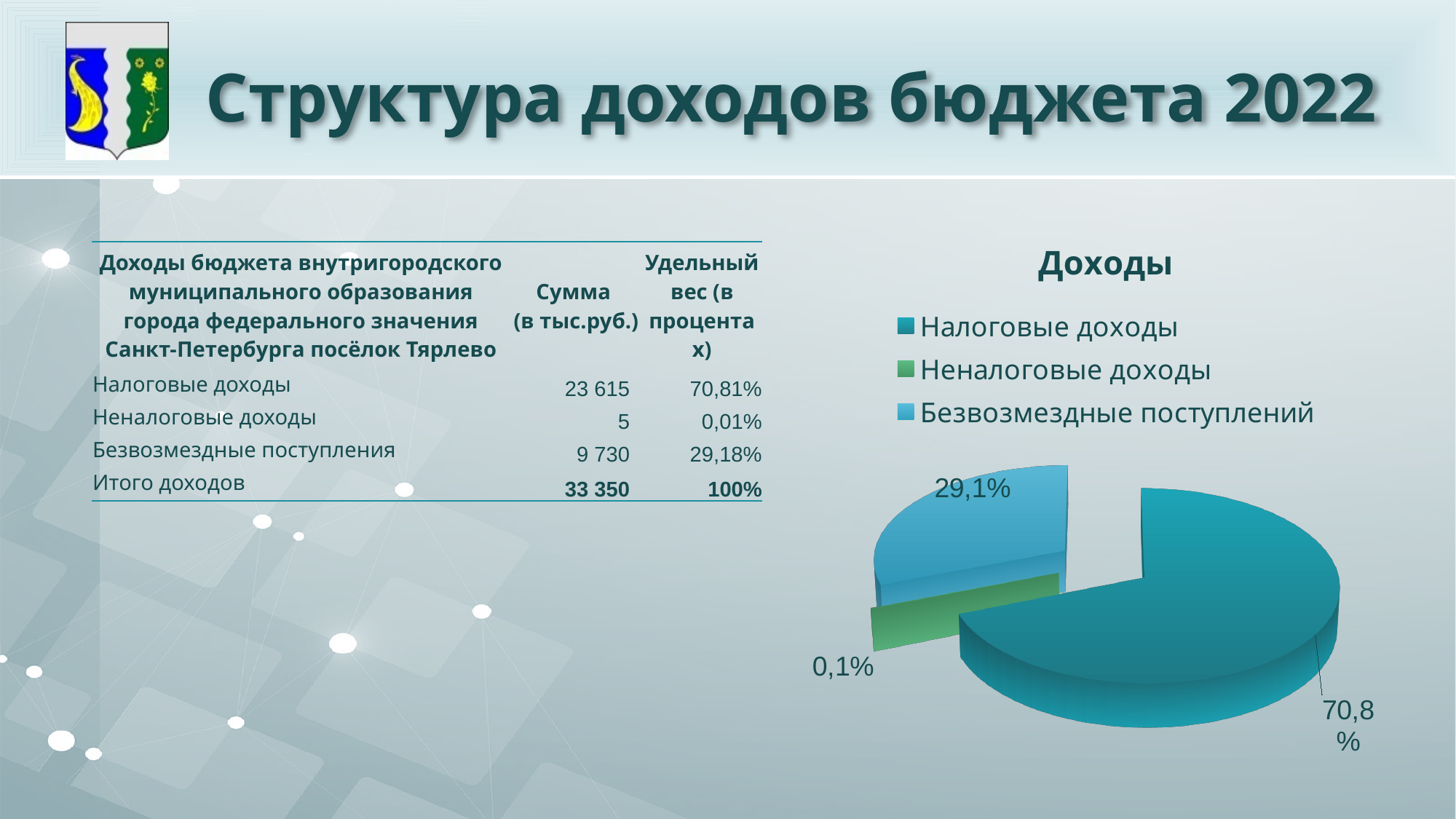
Which slice of the pie chart is the smallest? Неналоговые доходы What share of the pie does Неналоговые доходы take? 0,1% What kind of chart is shown on the slide? Pie chart Which legend entry is shown in green in the pie chart? Неналоговые доходы How many slices does the pie chart have? 3 Which is larger in the pie chart: Безвозмездные поступлений or Неналоговые доходы? Безвозмездные поступлений What share of the pie does Налоговые доходы take? 70,8% What is the difference in percentage points between the Налоговые доходы slice and the Безвозмездные поступлений slice? 41,7% What is the title of the chart? Доходы Which slice of the pie chart is the largest? Налоговые доходы How many entries does the chart legend list? 3 What share of the pie does Безвозмездные поступлений take? 29,1%